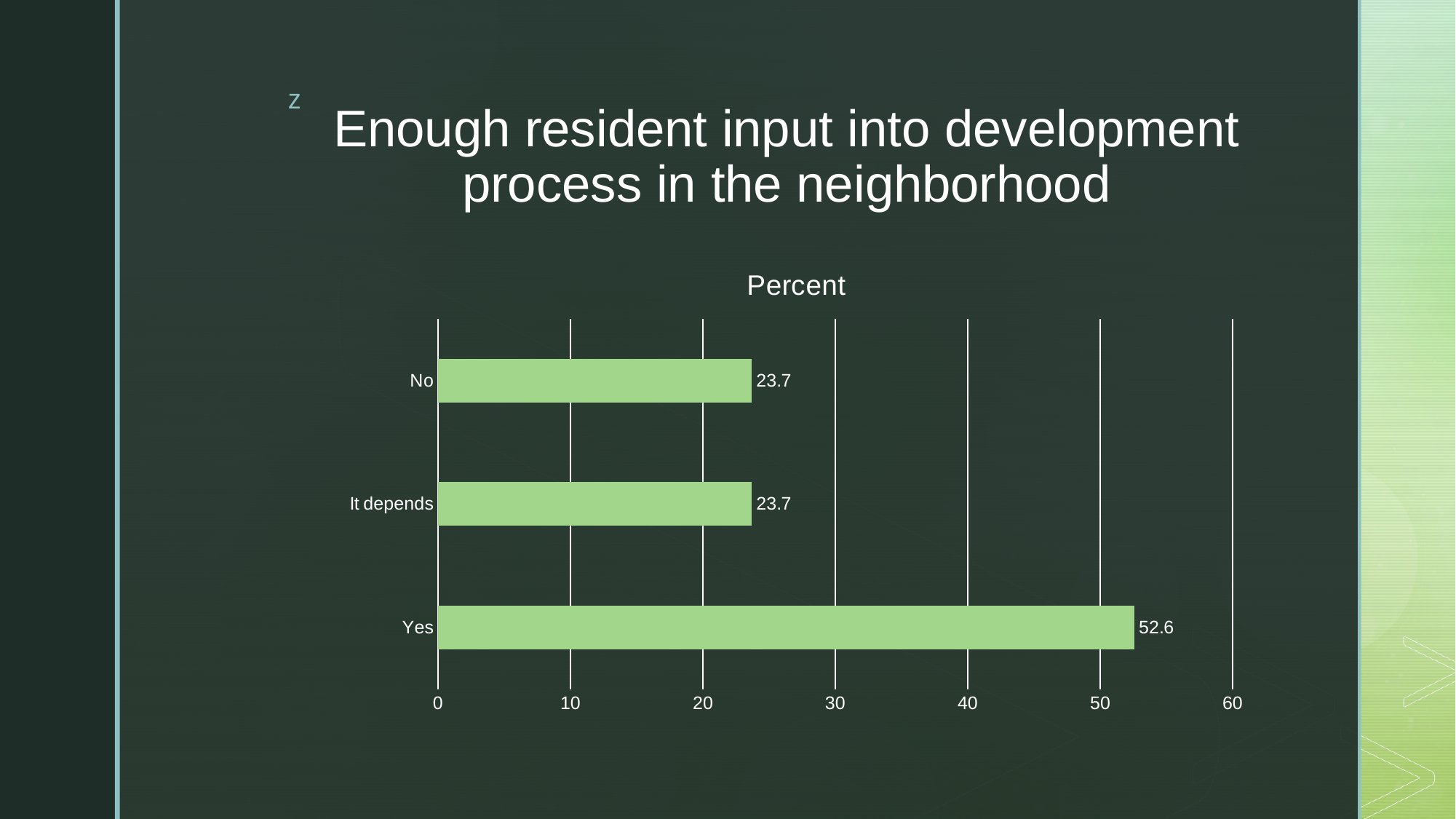
Is the value for No greater or less than 30? less Which is larger, the value for Yes or the value for It depends? Yes What kind of chart is shown on the slide? bar chart How many categories are shown in the chart? 3 What is the value for It depends? 23.7 What is the maximum value shown on the horizontal axis? 60 What is the difference between the values for Yes and No? 28.9 What is the value for No? 23.7 What is the value for Yes? 52.6 Which category has the highest value? Yes What is the title of the chart? Percent Is the value for Yes greater or less than 50? greater